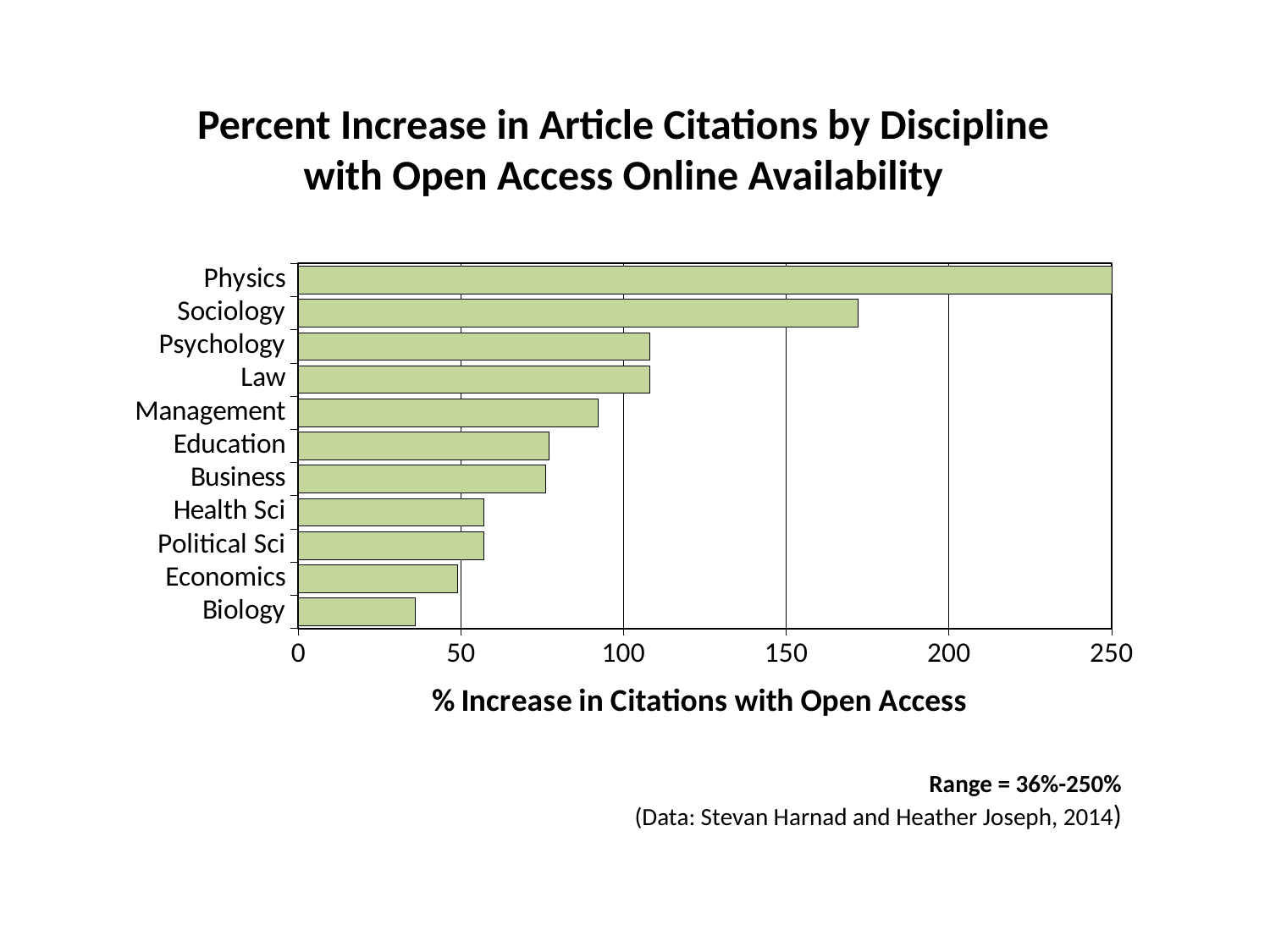
Which has a larger percent increase in citations, Sociology or Psychology? Sociology Is the value for Education greater or less than 50? greater Which discipline has the highest percent increase in citations? Physics What is the label of the horizontal axis? % Increase in Citations with Open Access What kind of chart is shown on the slide? bar chart Which discipline has the lowest percent increase in citations? Biology Is the value for Management greater or less than 100? less Is the value for Sociology greater or less than 150? greater Which has a larger percent increase in citations, Business or Biology? Business How many disciplines are plotted in the chart? 11 What is the percent increase in citations for Physics? 250